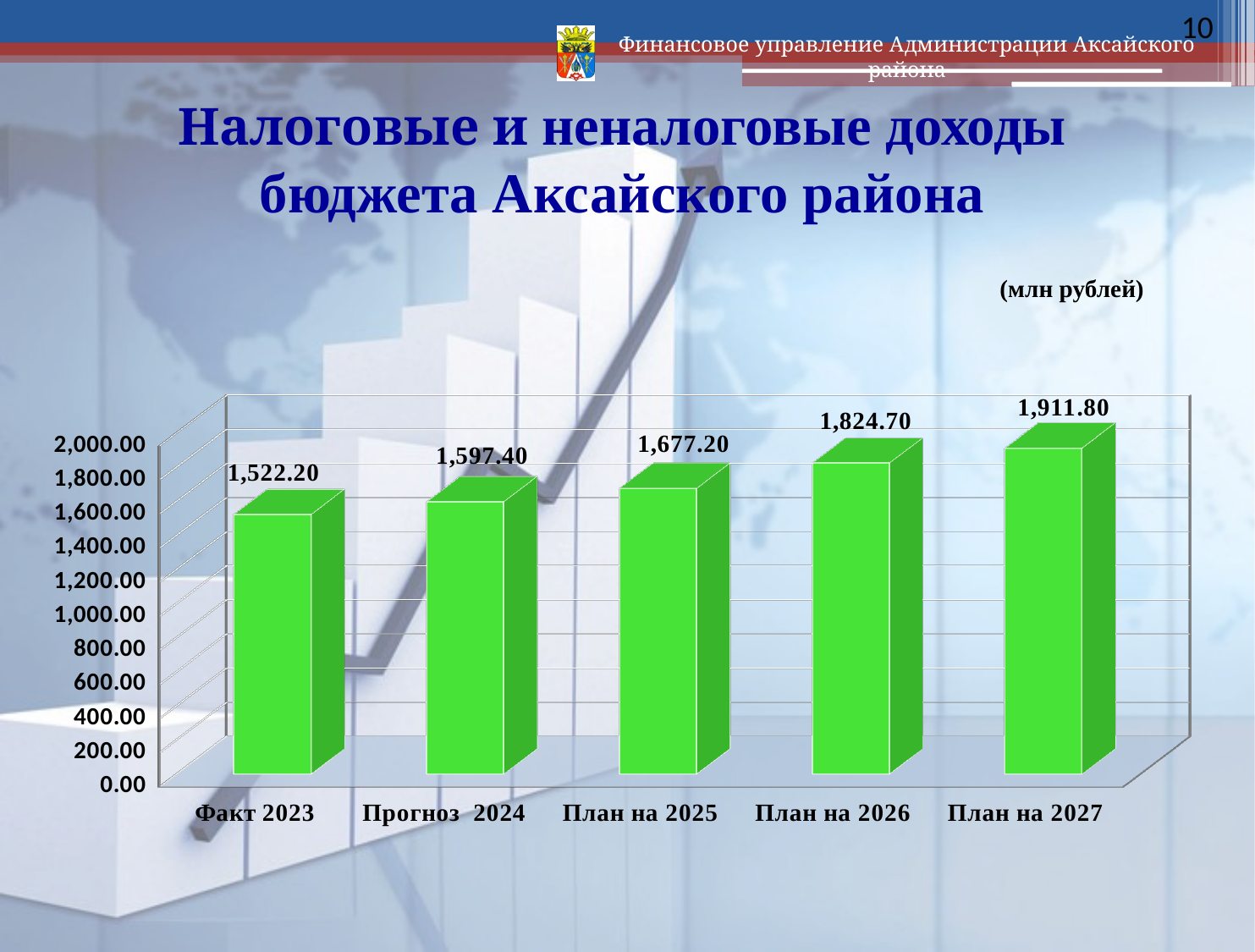
Do the values rise or fall from Факт 2023 to План на 2027? rise What is the value for Прогноз 2024? 1,597.40 Which is larger, the value for Прогноз 2024 or the value for План на 2026? План на 2026 What kind of chart is shown on the slide? bar chart How many categories are shown on the x axis? 5 What is the value for План на 2025? 1,677.20 What is the value for Факт 2023? 1,522.20 What is the value for План на 2027? 1,911.80 What is the difference between the values for План на 2025 and Факт 2023? 155.00 Which category has the lowest value? Факт 2023 What is the difference between the values for План на 2027 and План на 2026? 87.10 Which category has the highest value? План на 2027